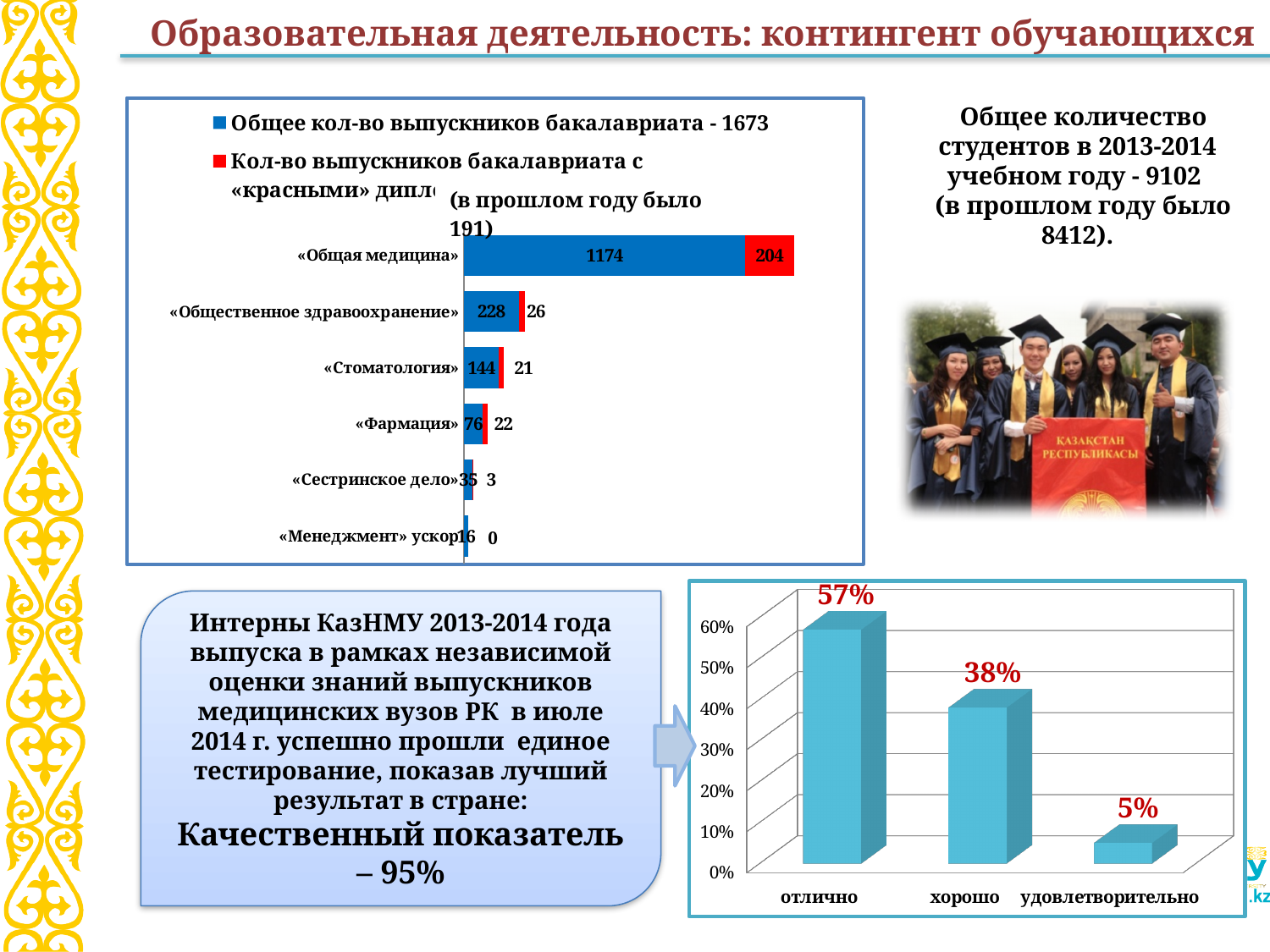
How many series does the legend of the top-left chart list? 2 In the top-left bar chart, what is the difference between the total graduates of «Общественное здравоохранение» and «Стоматология»? 84 How many categories are shown in the top-left bar chart? 6 In the top-left bar chart, what is the total number of bachelor graduates for «Общая медицина»? 1174 In the top-left bar chart, which has more graduates with «red» diplomas: «Стоматология» or «Фармация»? «Фармация» In the top-left bar chart, which category has the highest total number of bachelor graduates? «Общая медицина» In the top-left bar chart, how many graduates with «red» diplomas are shown for «Общественное здравоохранение»? 26 What type of chart is the bottom-right chart? Bar chart In the top-left bar chart, how many graduates with «red» diplomas are shown for «Фармация»? 22 In the bottom-right chart, what is the difference between «отлично» and «удовлетворительно»? 52% In the top-left bar chart, which category has the lowest number of graduates with «red» diplomas? «Менеджмент» ускор In the bottom-right chart, what is the value for «хорошо»? 38%